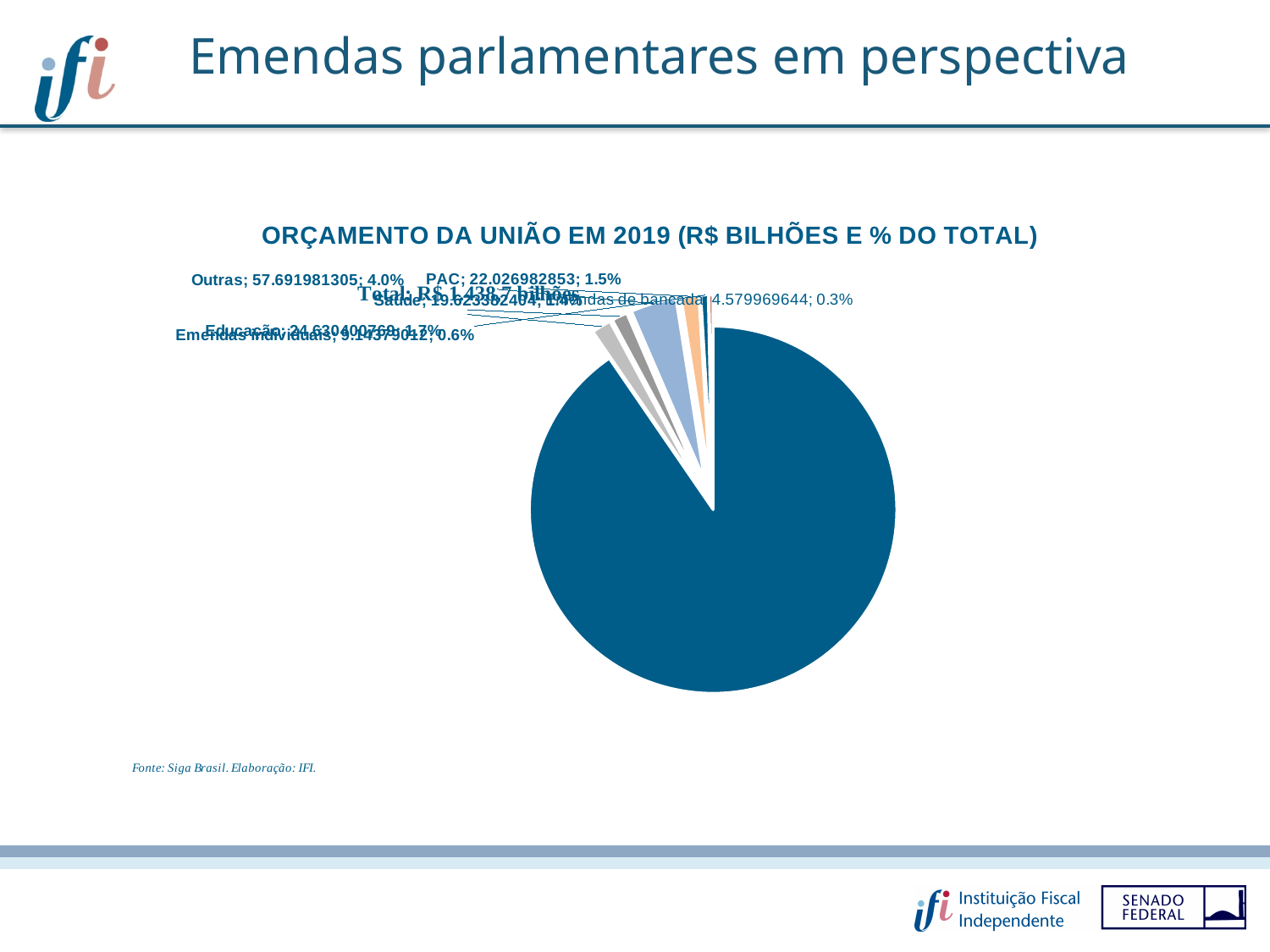
What value (in R$ billions) is shown for "Outras"? 57.691981305 What is the title of the chart? ORÇAMENTO DA UNIÃO EM 2019 (R$ BILHÕES E % DO TOTAL) What value (in R$ billions) is shown for "PAC"? 22.026982853 What share of the total does the "PAC" slice represent? 1.5% What source is cited below the chart? Siga Brasil. Elaboração: IFI. What kind of chart is shown on the slide? pie chart What share of the total does the "Outras" slice represent? 4.0% Which slice is larger, "PAC" or "Emendas de bancada"? PAC What share of the total does the "Emendas de bancada" slice represent? 0.3% What value (in R$ billions) is shown for "Emendas de bancada"? 4.579969644 Which slice is larger, "Outras" or "PAC"? Outras What is the difference in percentage points between the shares of "Outras" and "PAC"? 2.5 percentage points